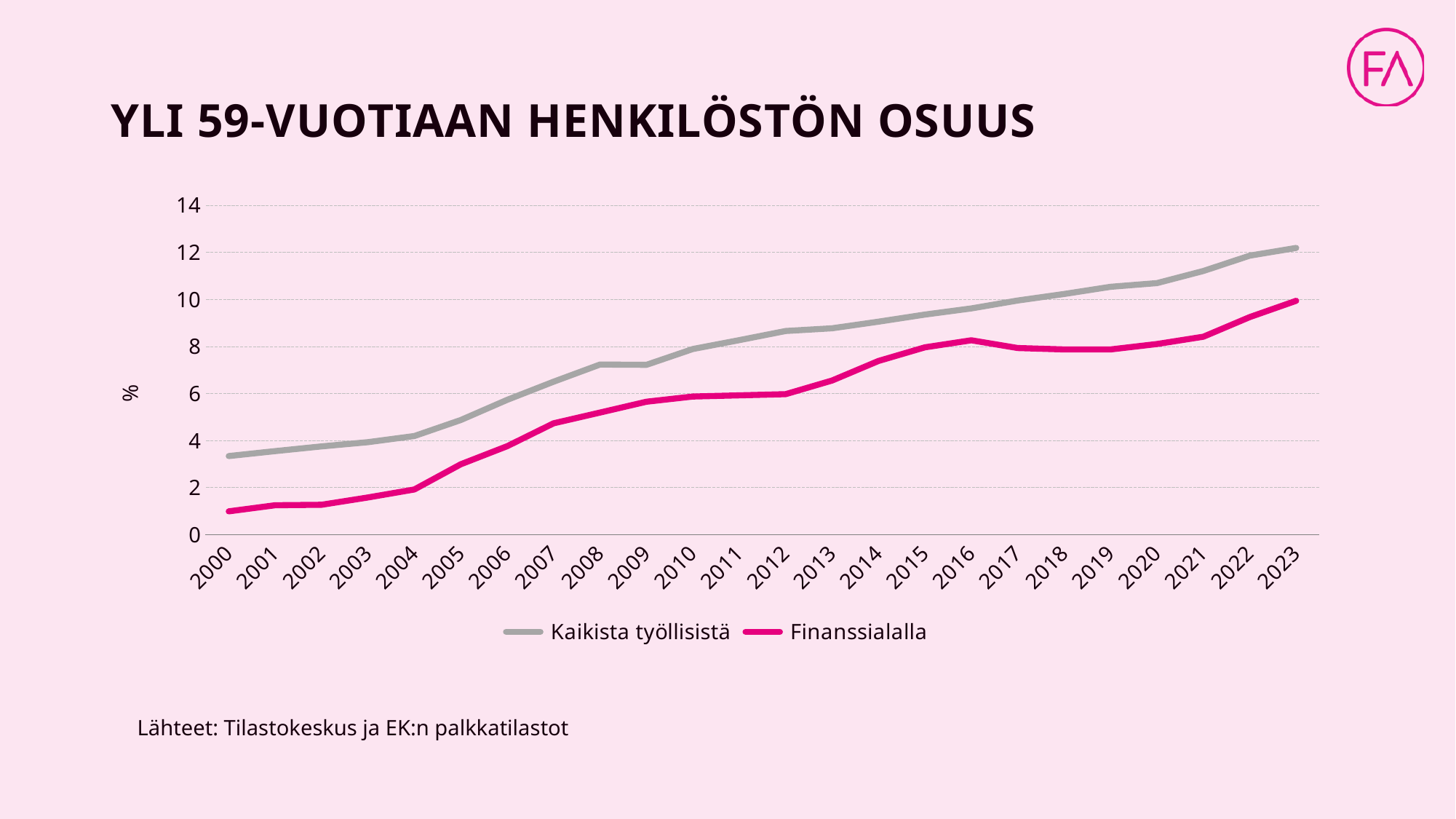
In which year is the Kaikista työllisistä value lowest? 2000 Does the Kaikista työllisistä line rise or fall from 2000 to 2023? rise Is the Kaikista työllisistä value for 2023 greater or less than 10? greater What kind of chart is shown on the slide? line chart Is the Finanssialalla value for 2000 greater or less than 2? less In which year is the Finanssialalla value highest? 2023 How many years are plotted along the x axis? 24 Which series is drawn in pink? Finanssialalla How many series does the legend list? 2 What is the title of the chart? YLI 59-VUOTIAAN HENKILÖSTÖN OSUUS In 2023, which series has the larger value, Kaikista työllisistä or Finanssialalla? Kaikista työllisistä Is the Finanssialalla value for 2016 greater or less than 6? greater